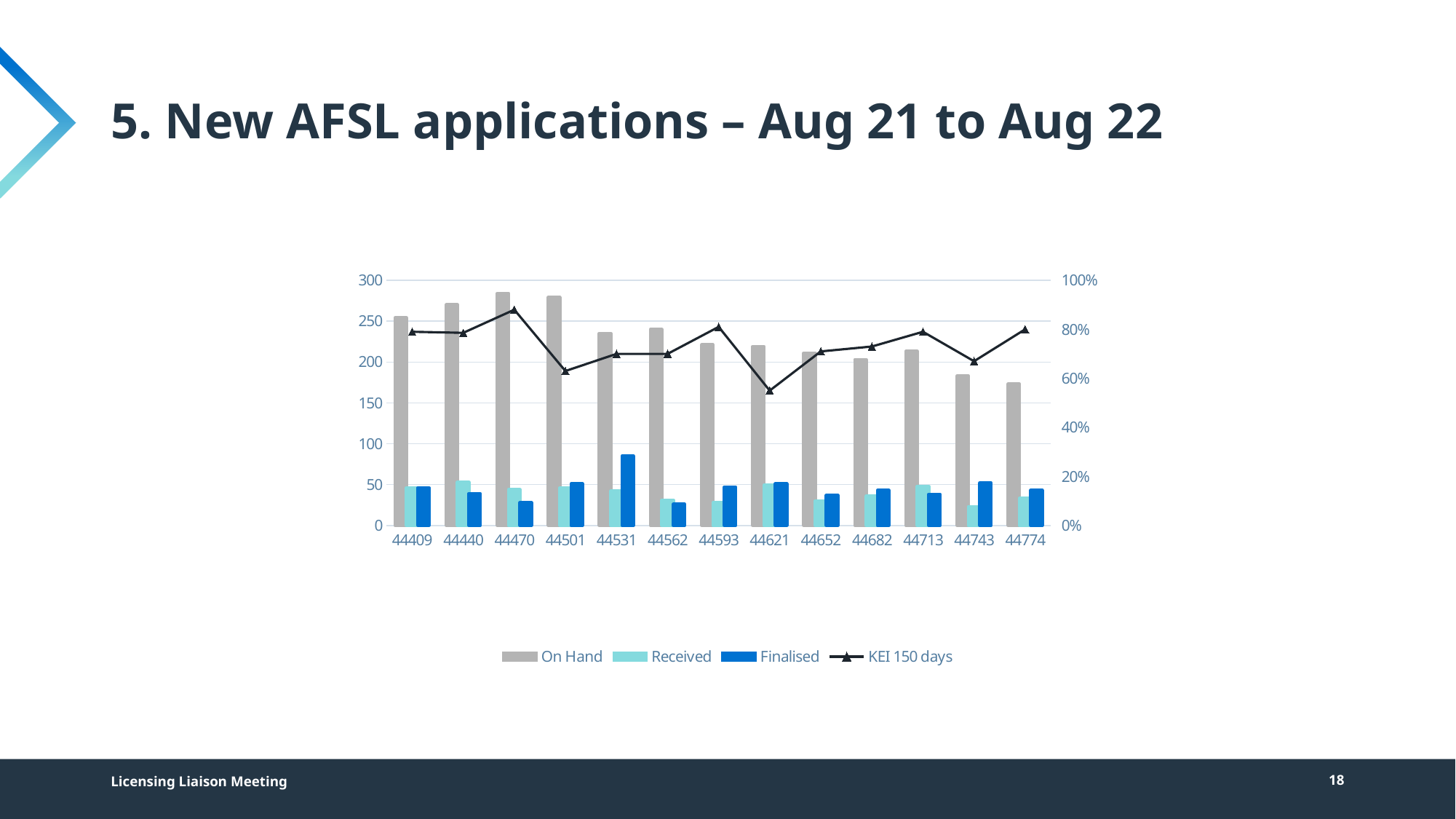
Which series is plotted as a line with triangle markers? KEI 150 days Is the KEI 150 days value for 44621 greater or less than 60%? less How many series does the legend list? 4 Which category has the lowest On Hand value? 44774 How many categories are shown along the x axis? 13 Which category has the highest Finalised value? 44531 Is the On Hand value for 44774 greater or less than 200? less Which category has the lowest KEI 150 days value? 44621 What kind of chart is shown on the slide? A combined bar and line chart Which is larger, the Finalised value for 44531 or for 44562? 44531 Is the On Hand value for 44470 greater or less than 250? greater Which category has the highest On Hand value? 44470